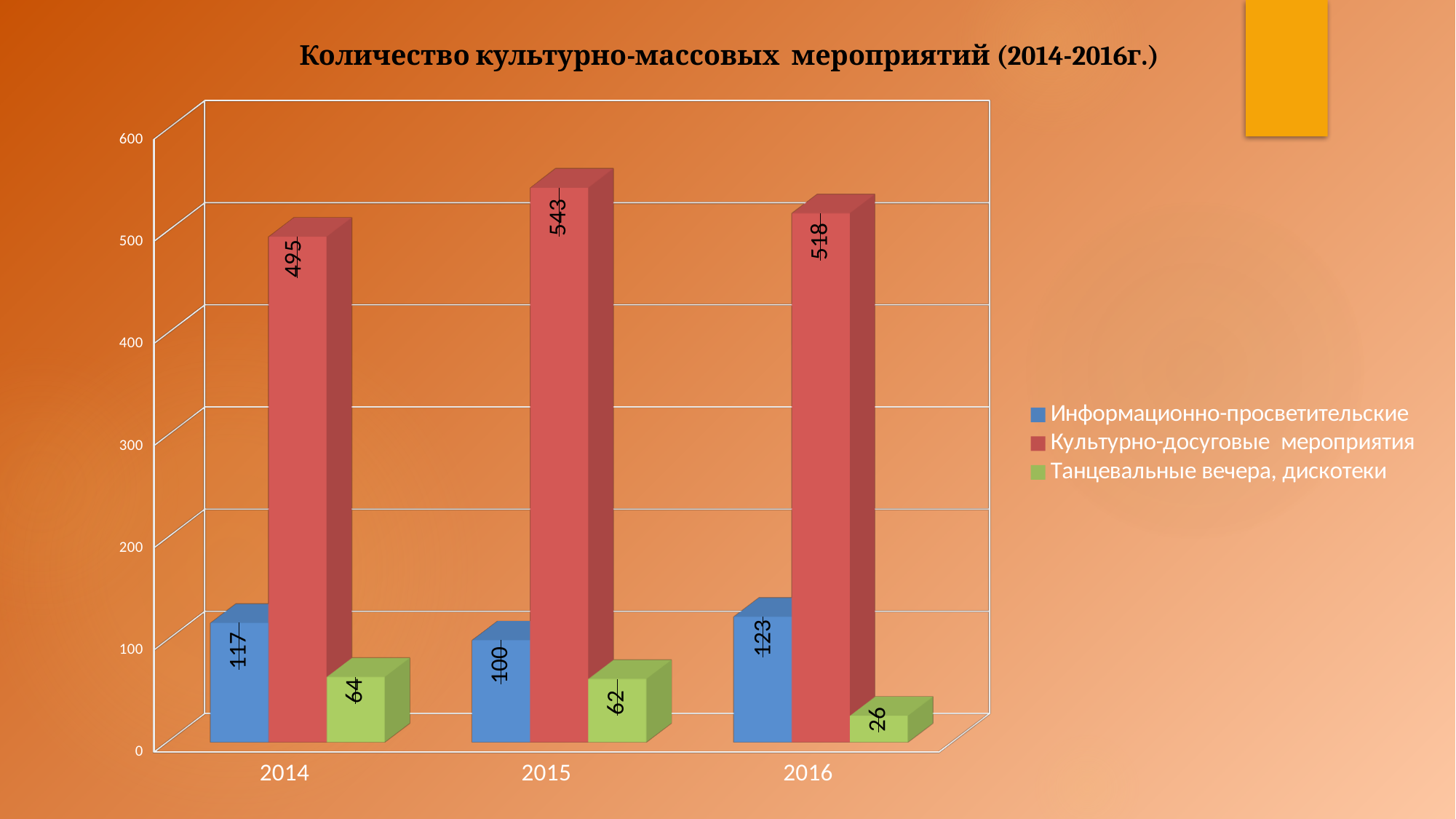
How many series does the legend list? 3 What is the difference between the Культурно-досуговые мероприятия values for 2015 and 2014? 48 How many years are shown on the x axis? 3 What kind of chart is shown on the slide? bar chart In which year is the value for Культурно-досуговые мероприятия highest? 2015 In which year is the value for Танцевальные вечера, дискотеки lowest? 2016 What is the value for Информационно-просветительские in 2014? 117 What is the value for Культурно-досуговые мероприятия in 2015? 543 What is the value for Танцевальные вечера, дискотеки in 2016? 26 Which is larger: Информационно-просветительские in 2016 or in 2015? 2016 What is the title of the chart? Количество культурно-массовых мероприятий (2014-2016г.) Is the value for Культурно-досуговые мероприятия in 2016 greater or less than 500? greater